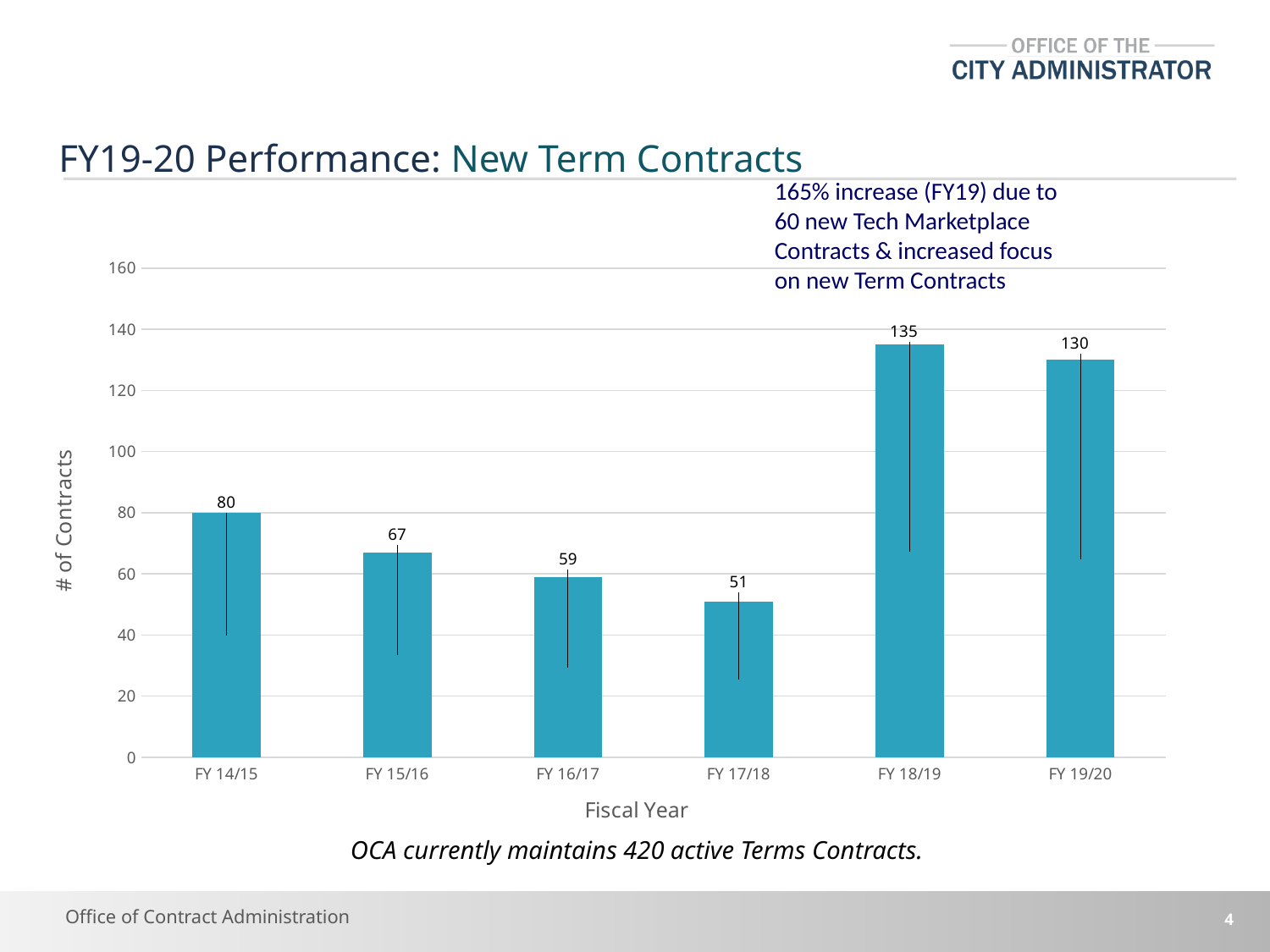
Which fiscal year has the highest number of contracts? FY 18/19 What kind of chart is shown on the slide? Bar chart Which fiscal year has the lowest number of contracts? FY 17/18 Which is larger, the value for FY 16/17 or the value for FY 19/20? FY 19/20 What is the value for FY 17/18? 51 Do the values rise or fall from FY 14/15 to FY 17/18? Fall What is the difference between the values for FY 18/19 and FY 17/18? 84 How many new term contracts were there in FY 18/19? 135 What is the label of the y axis? # of Contracts What is the value for FY 14/15? 80 What is the difference between the values for FY 14/15 and FY 15/16? 13 How many fiscal years are shown on the x axis? 6